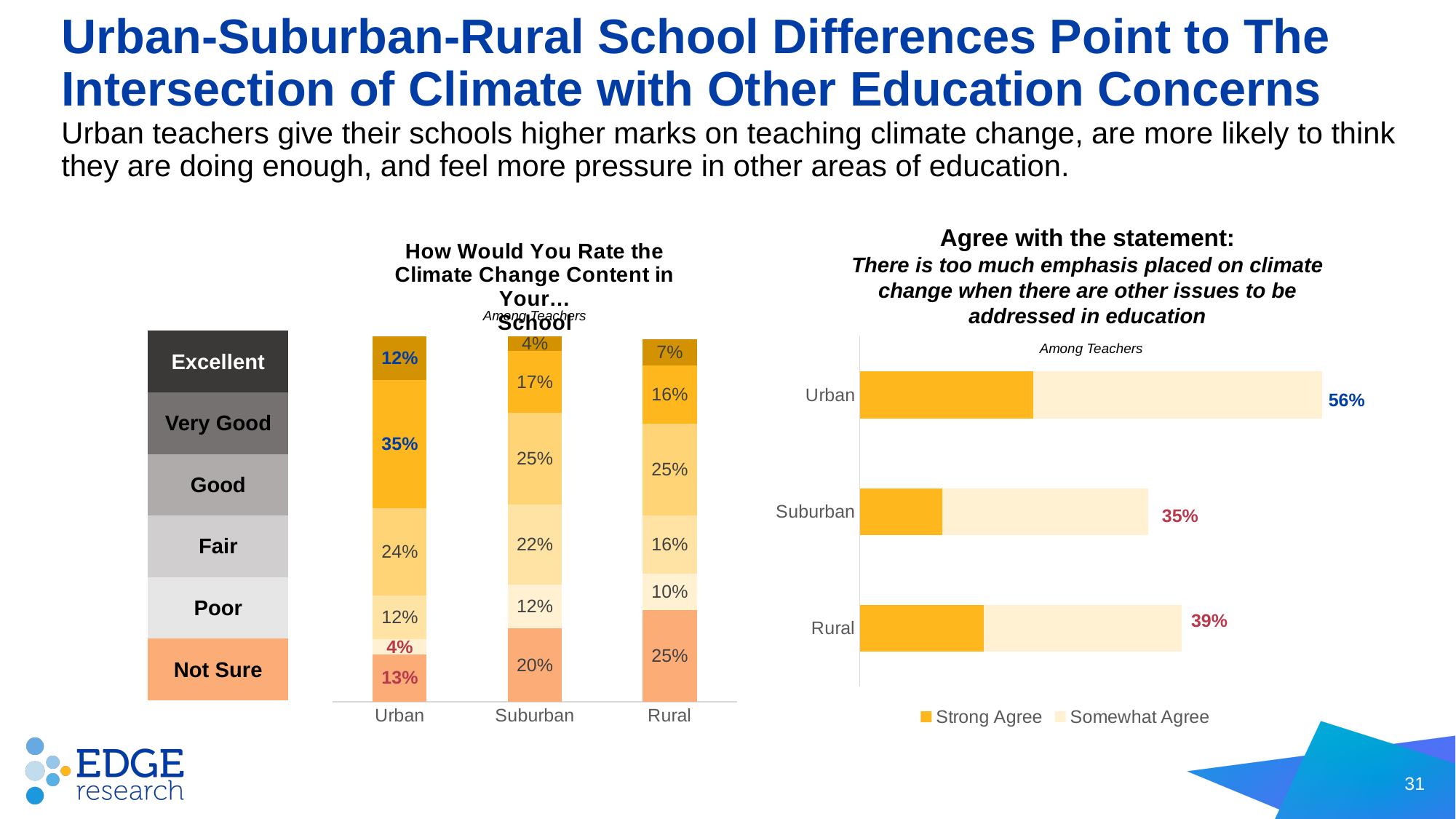
In the left chart 'How Would You Rate the Climate Change Content in Your School', which group has the lowest share of Excellent ratings? Suburban In the left chart 'How Would You Rate the Climate Change Content in Your School', which group has the highest share of Very Good ratings? Urban In the left chart 'How Would You Rate the Climate Change Content in Your School', how many percentage points higher is the Very Good share for Urban than for Suburban? 18 percentage points In the left chart 'How Would You Rate the Climate Change Content in Your School', what percentage of Rural teachers rated it Very Good? 16% In the left chart 'How Would You Rate the Climate Change Content in Your School', how many school groups are shown on the x axis? 3 In the left chart 'How Would You Rate the Climate Change Content in Your School', what percentage of Urban teachers rated it Excellent? 12% In the right chart 'Agree with the statement: There is too much emphasis placed on climate change...', how many series does the legend list? 2 In the left chart 'How Would You Rate the Climate Change Content in Your School', what percentage of Suburban teachers answered Not Sure? 20% In the right chart 'Agree with the statement: There is too much emphasis placed on climate change...', what percentage of Urban teachers agree? 56% In the right chart 'Agree with the statement: There is too much emphasis placed on climate change...', which group has the highest agreement? Urban In the right chart 'Agree with the statement: There is too much emphasis placed on climate change...', what kind of chart is used? Stacked bar chart In the right chart 'Agree with the statement: There is too much emphasis placed on climate change...', which group has the lowest agreement? Suburban